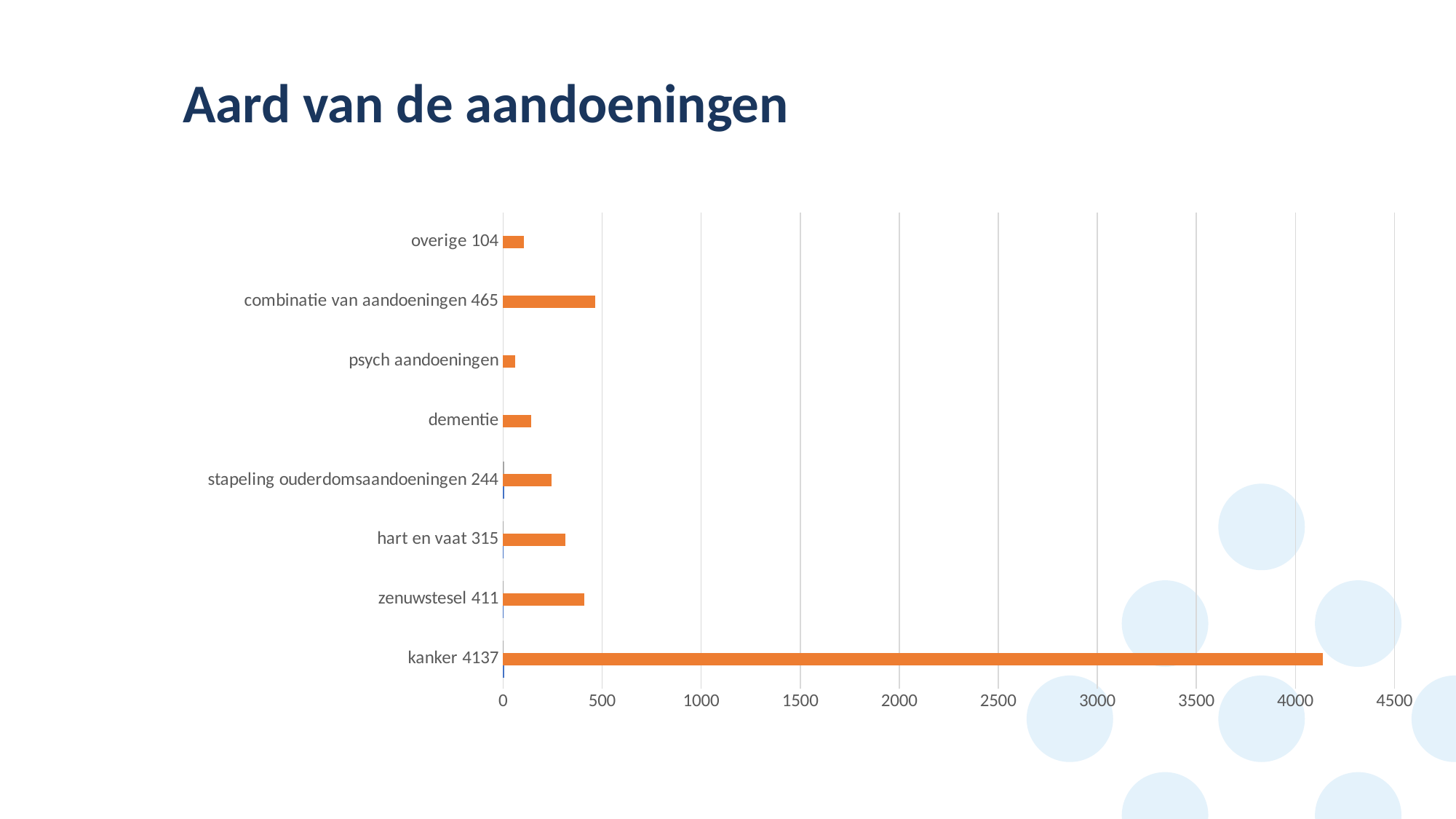
What is the value for kanker? 4137 What is the value for hart en vaat? 315 Which category has the lowest value? psych aandoeningen How many categories are shown in the chart? 8 What type of chart is shown on the slide? bar chart What is the difference between the values for kanker and zenuwstesel? 3726 Which is larger, the value for combinatie van aandoeningen or the value for zenuwstesel? combinatie van aandoeningen What is the value for combinatie van aandoeningen? 465 What is the highest value shown on the horizontal axis? 4500 Is the value for dementie greater or less than 500? less Which category has the highest value? kanker What is the title of the chart? Aard van de aandoeningen